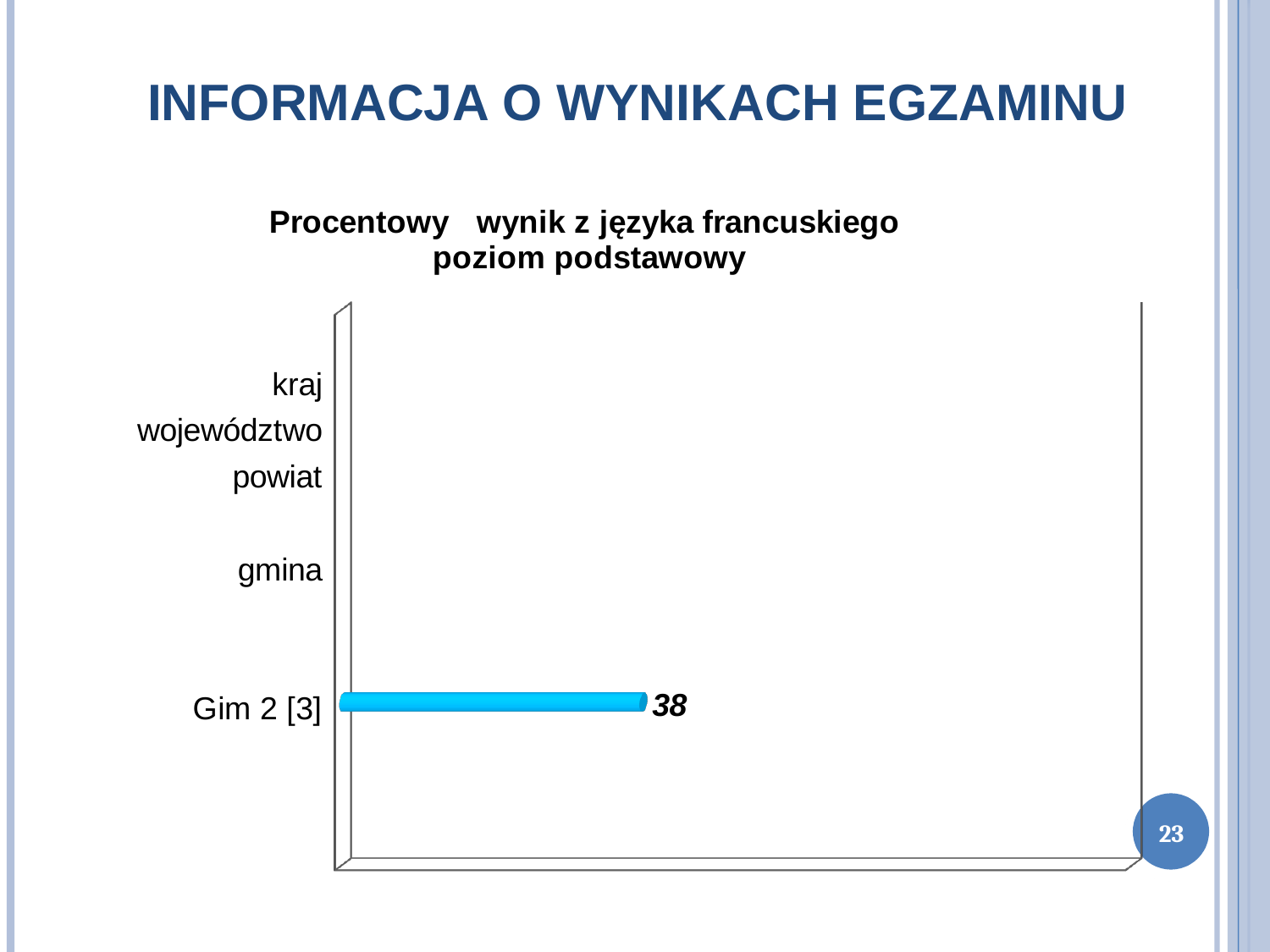
Which category appears at the top of the vertical axis? kraj Which category is the only one with a plotted bar? Gim 2 [3] Which category appears at the bottom of the vertical axis? Gim 2 [3] What kind of chart is shown on the slide? bar chart What is the value shown for Gim 2 [3]? 38 How many categories are listed on the vertical axis of the chart? 5 What colour is the bar for Gim 2 [3]? blue How many bars are actually plotted in the chart? 1 What is the title of the chart? Procentowy wynik z języka francuskiego poziom podstawowy